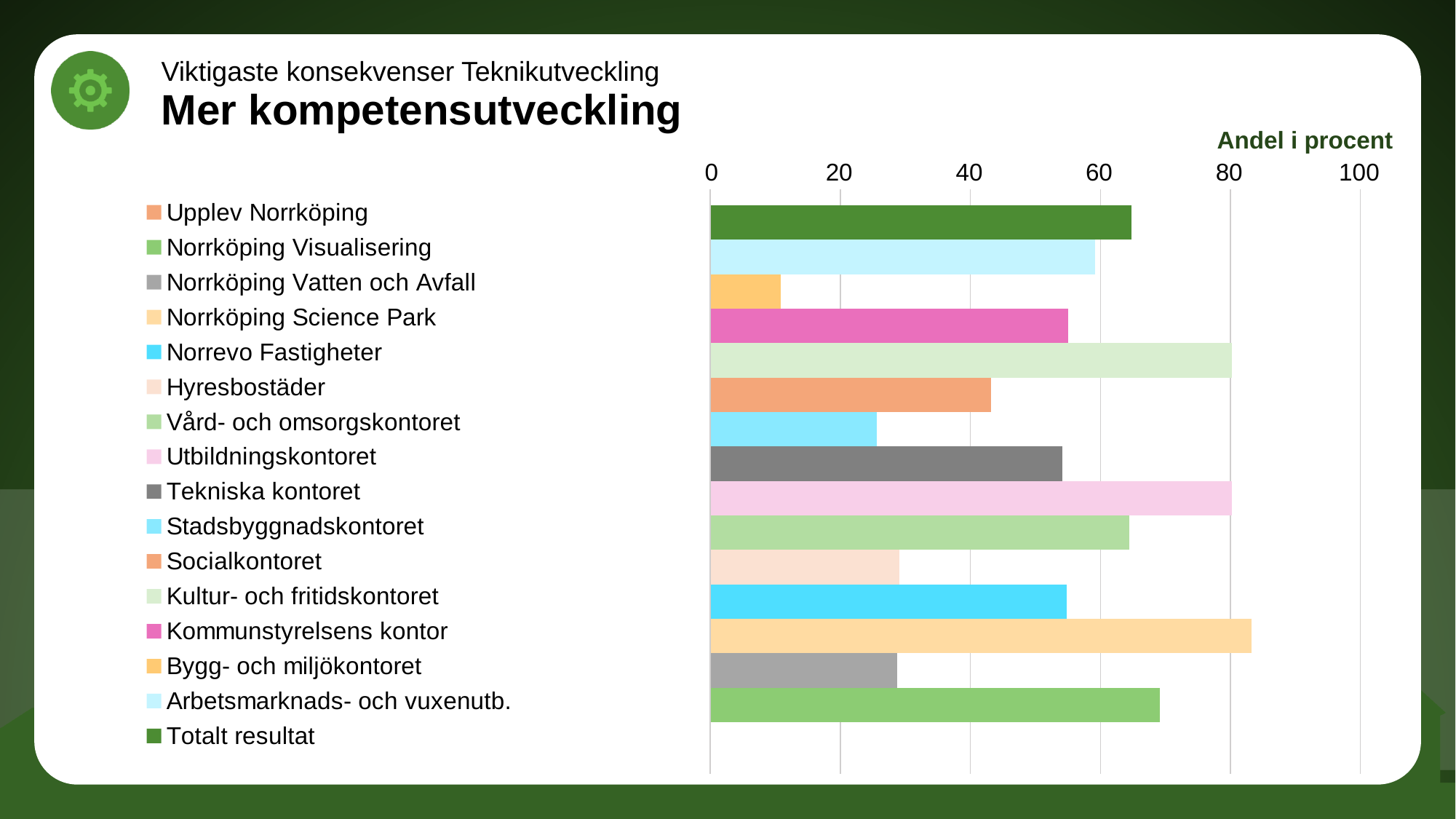
Is the value for Bygg- och miljökontoret greater or less than 20? less Is the value for Totalt resultat greater or less than 60? greater Is the value for Norrköping Visualisering greater or less than 60? greater How many entries does the chart's legend list? 16 Which has the larger value, Kultur- och fritidskontoret or Socialkontoret? Kultur- och fritidskontoret What kind of chart is shown on the slide? bar chart Which has the larger value, Totalt resultat or Bygg- och miljökontoret? Totalt resultat What is the title of the chart's value axis? Andel i procent